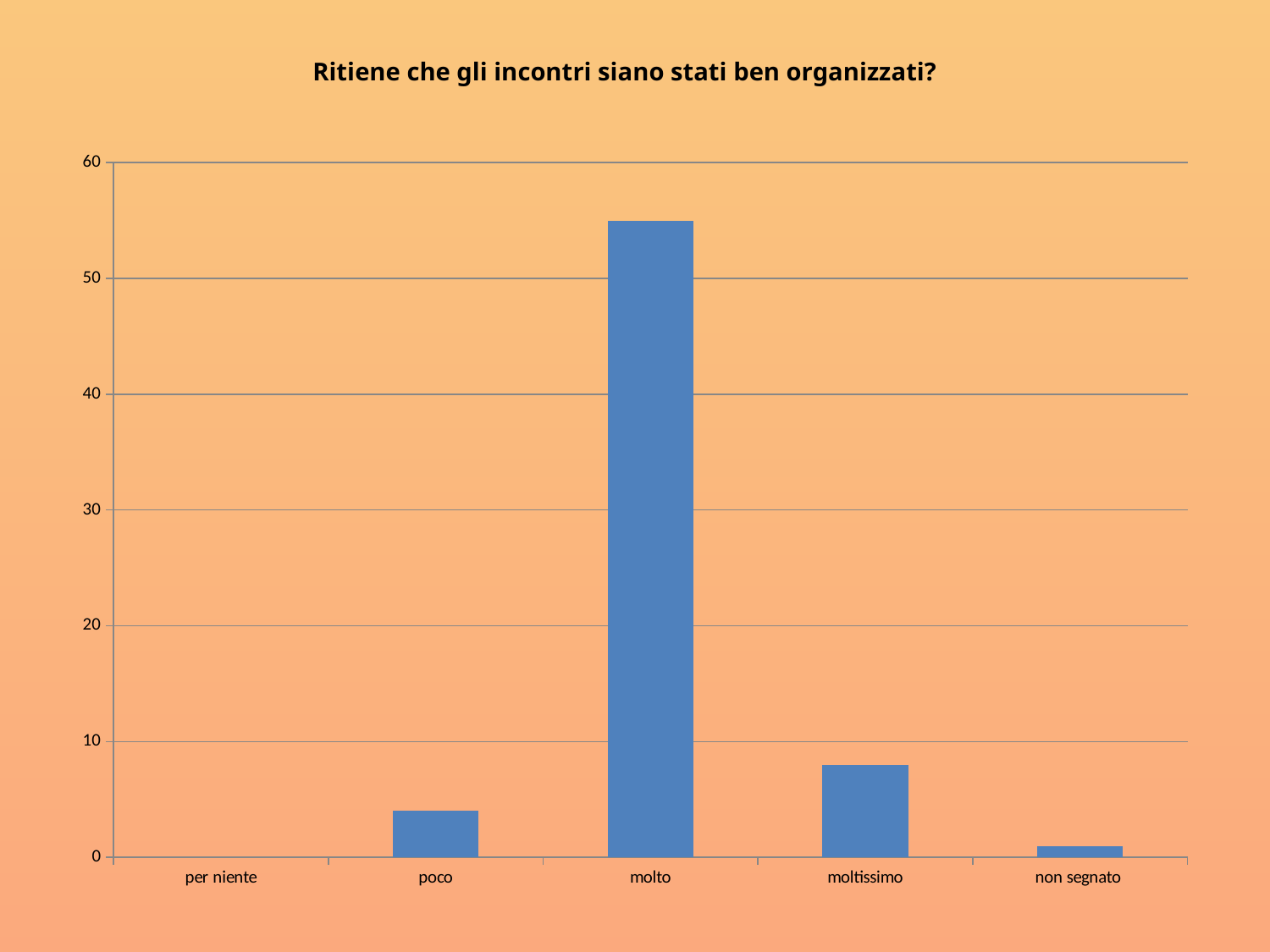
Is the value for molto greater or less than 50? greater Is the value for molto greater or less than 60? less What kind of chart is shown on the slide? bar chart Is the value for poco greater or less than 10? less Which category has the highest value? molto Which is larger, the value for poco or the value for moltissimo? moltissimo What colour are the bars in the chart? blue What is the title of the chart? Ritiene che gli incontri siano stati ben organizzati? Which category has the lowest value? per niente How many categories are shown on the x axis of the chart? 5 Which is larger, the value for molto or the value for moltissimo? molto